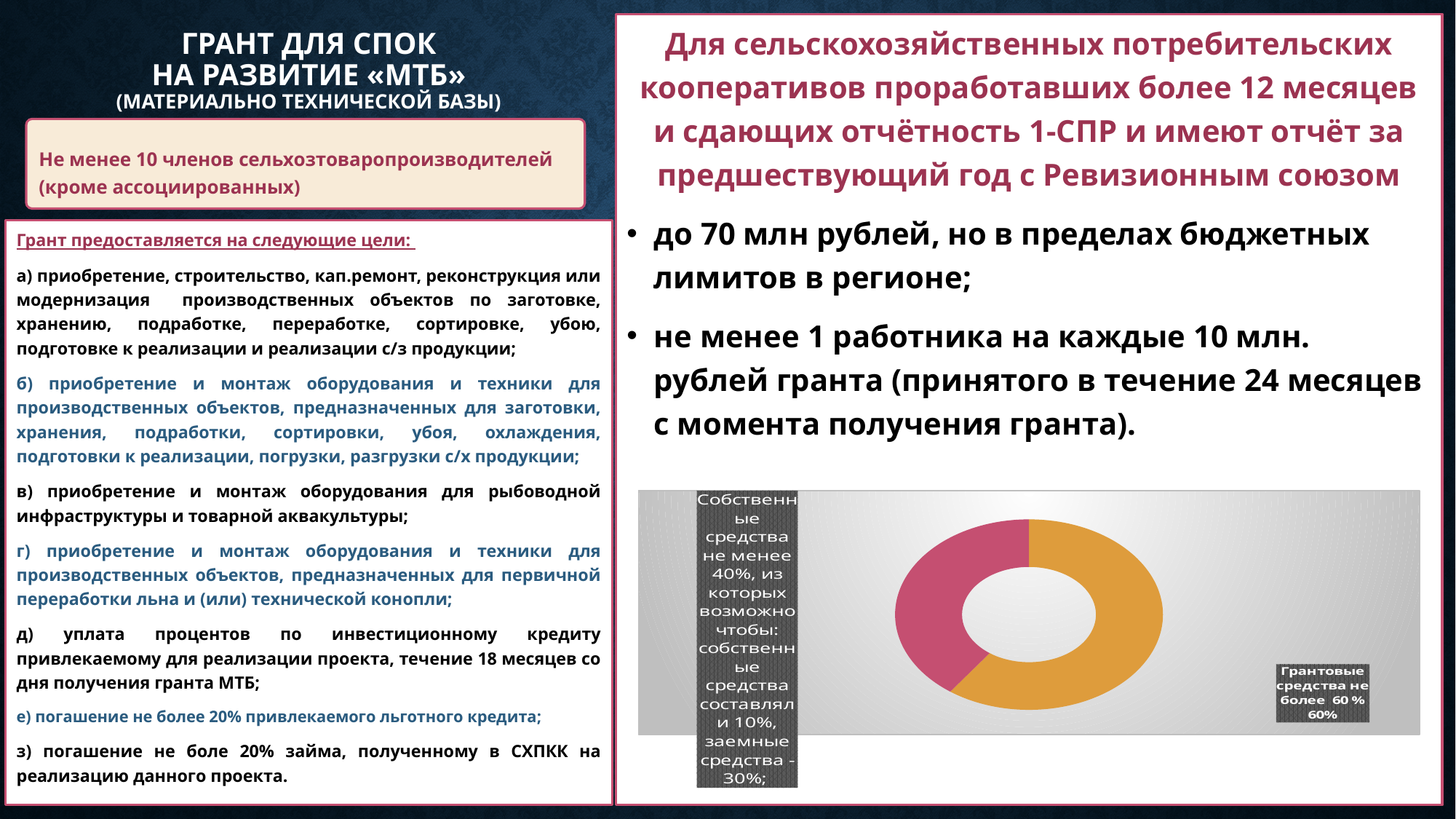
How many slices does the doughnut chart have? 2 According to the own funds label, what share may be borrowed funds ("заемные средства")? 30% What kind of chart is shown on the slide? doughnut (pie) chart Which is larger in the doughnut chart: the grant funds slice or the own funds slice? Грантовые средства What colour is the grant funds ("Грантовые средства") slice in the doughnut chart? orange What is the difference between the grant funds share (60%) and the own funds share (40%) in the chart? 20% What percentage is printed on the data label for the grant funds ("Грантовые средства") slice? 60% What minimum share is stated in the label for own funds ("Собственные средства")? не менее 40% Which slice of the doughnut chart is the largest? Грантовые средства What colour is the own funds ("Собственные средства") slice in the doughnut chart? pink What share of the doughnut chart is labelled for "Грантовые средства"? 60% Which slice of the doughnut chart is the smallest? Собственные средства